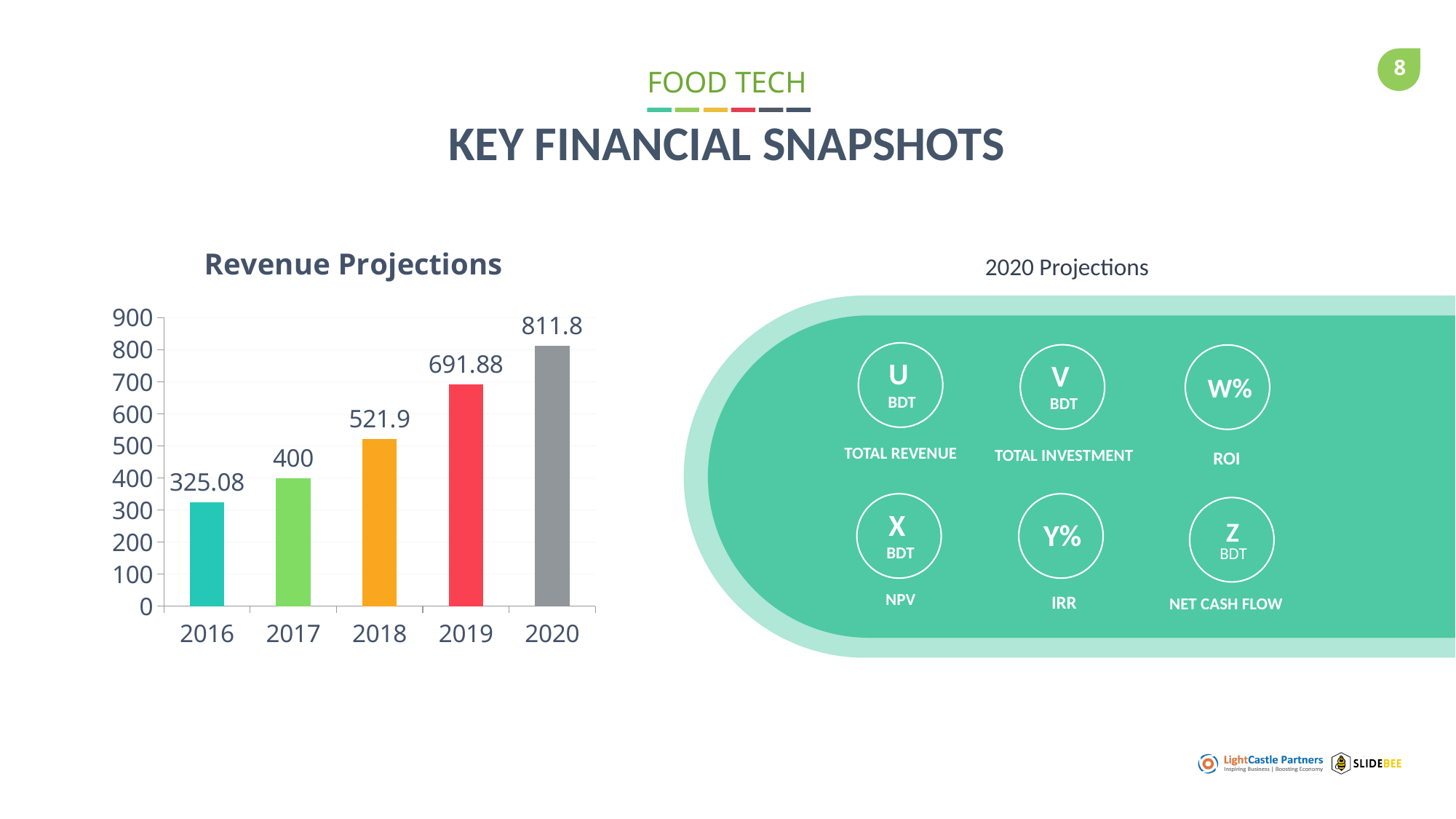
What is the revenue projection for 2018? 521.9 Do the revenue projections rise or fall from 2016 to 2020? rise Which is larger, the revenue projection for 2017 or for 2019? 2019 What is the revenue projection for 2016? 325.08 Which year has the highest revenue projection? 2020 Which year has the lowest revenue projection? 2016 What is the difference between the revenue projections for 2017 and 2016? 74.92 What kind of chart is the Revenue Projections chart? bar chart Is the revenue projection for 2019 greater or less than 600? greater How many years are shown in the Revenue Projections chart? 5 What is the difference between the revenue projections for 2019 and 2018? 169.98 What is the revenue projection for 2020? 811.8